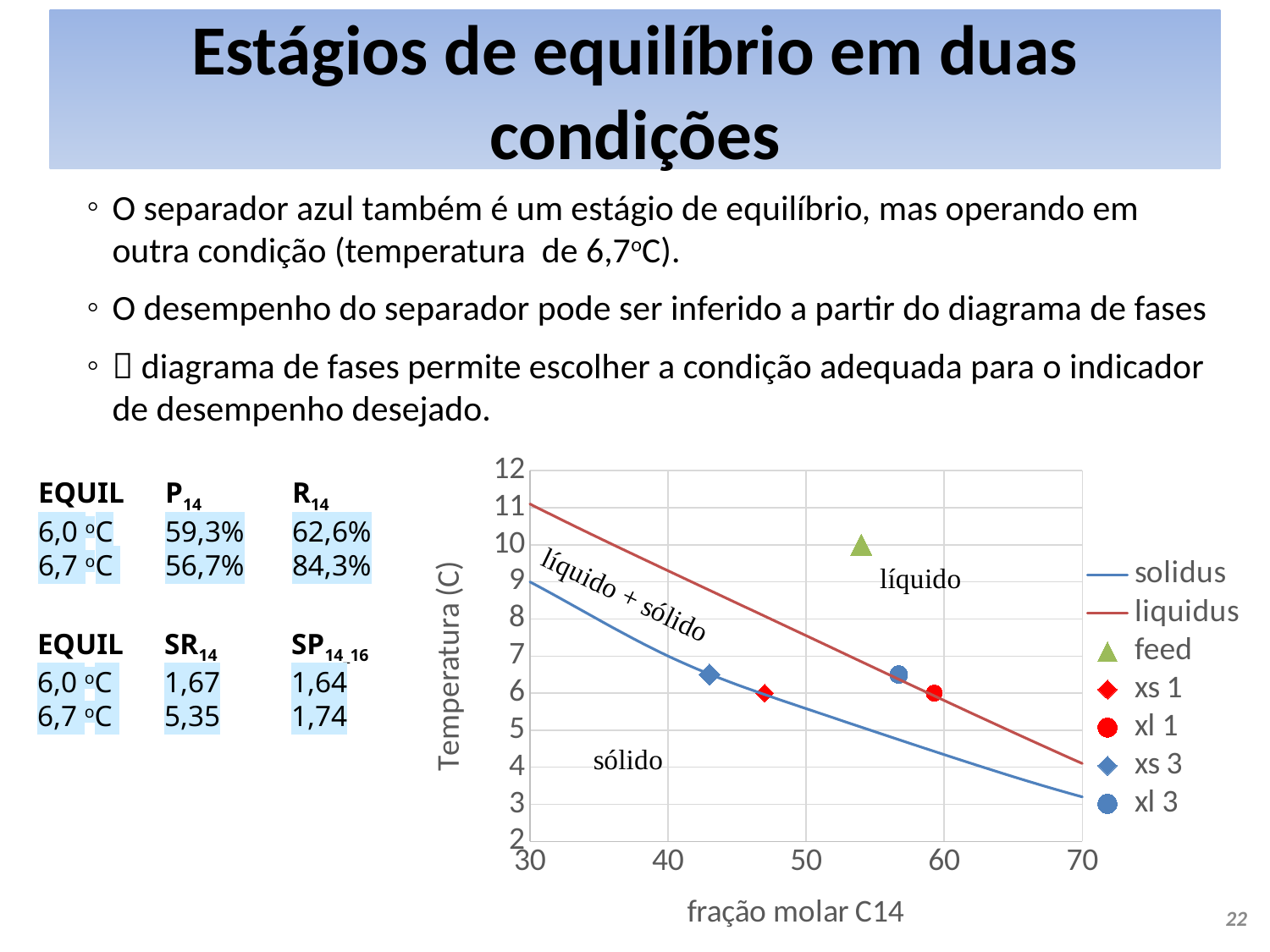
What is the title of the x axis of the chart? fração molar C14 Which point has the higher temperature, feed or xl 1? feed Which series is drawn as a green triangle in the chart? feed Is the C14 mole fraction of the xs 3 point greater or less than 50? less Is the temperature of the xs 3 point greater or less than 7? less Is the C14 mole fraction of the xl 1 point greater or less than 50? greater What is the title of the y axis of the chart? Temperatura (C) Which point has the larger C14 mole fraction, xs 1 or xl 1? xl 1 Does the solidus line rise or fall as the C14 mole fraction increases? fall How many series does the chart legend list? 7 What kind of chart is shown on the slide? line chart with scatter points (phase diagram)